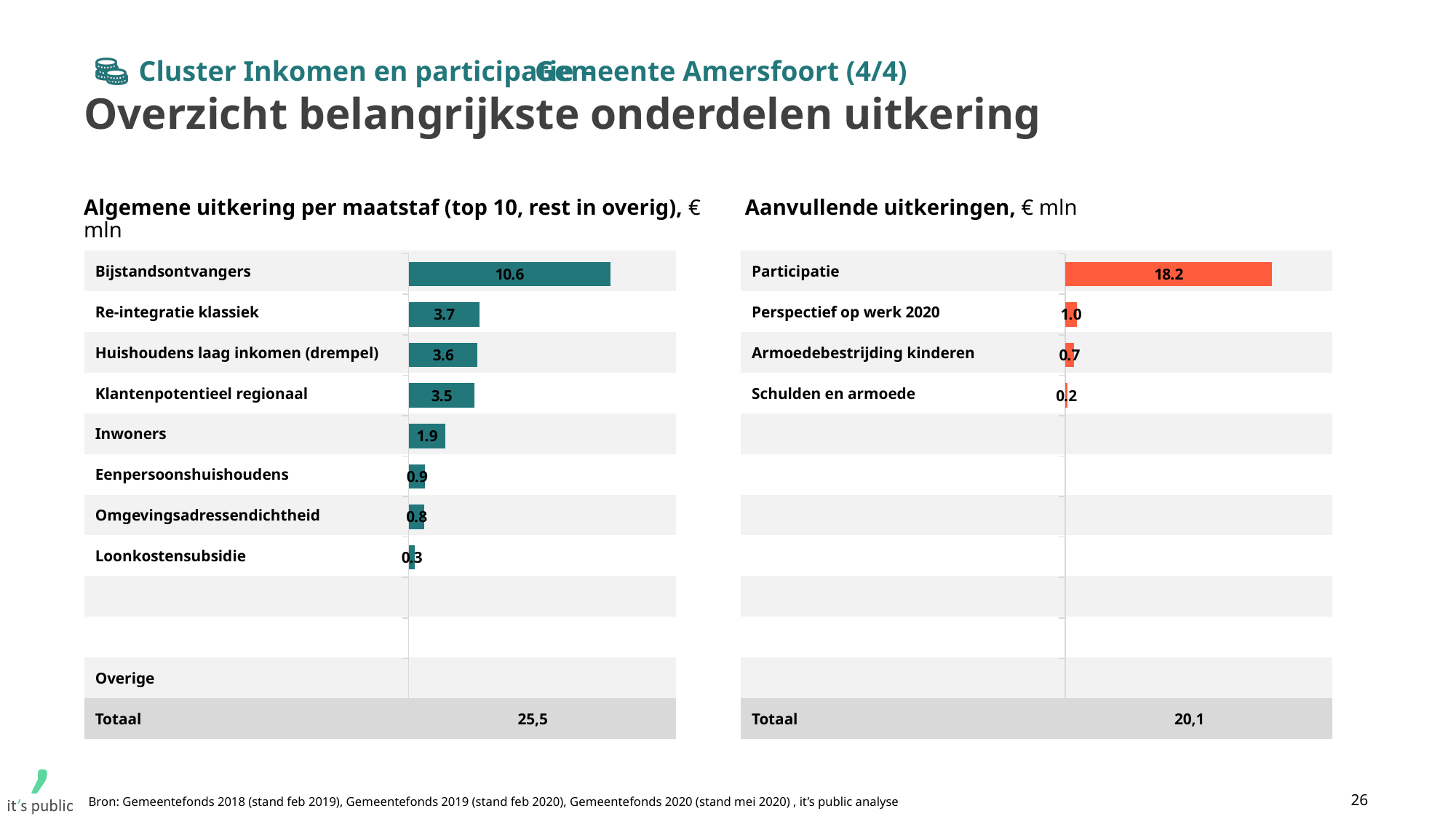
In the 'Algemene uitkering per maatstaf' chart, what is the value for Bijstandsontvangers? 10.6 In the 'Aanvullende uitkeringen' chart, what is the difference between Participatie and Perspectief op werk 2020? 17.2 In the 'Algemene uitkering per maatstaf' chart, what is the value for Klantenpotentieel regionaal? 3.5 In the 'Algemene uitkering per maatstaf' chart, which category has the highest value? Bijstandsontvangers What kind of chart is the 'Aanvullende uitkeringen' chart? Bar chart In the 'Algemene uitkering per maatstaf' chart, what is the difference between Bijstandsontvangers and Re-integratie klassiek? 6.9 In the 'Algemene uitkering per maatstaf' chart, which is larger: Inwoners or Eenpersoonshuishoudens? Inwoners How many categories have bars in the 'Aanvullende uitkeringen' chart? 4 In the 'Aanvullende uitkeringen' chart, what is the value for Armoedebestrijding kinderen? 0.7 In the 'Aanvullende uitkeringen' chart, what is the value for Participatie? 18.2 In the 'Algemene uitkering per maatstaf' chart, which category has the lowest value? Loonkostensubsidie In the 'Aanvullende uitkeringen' chart, which category has the lowest value? Schulden en armoede